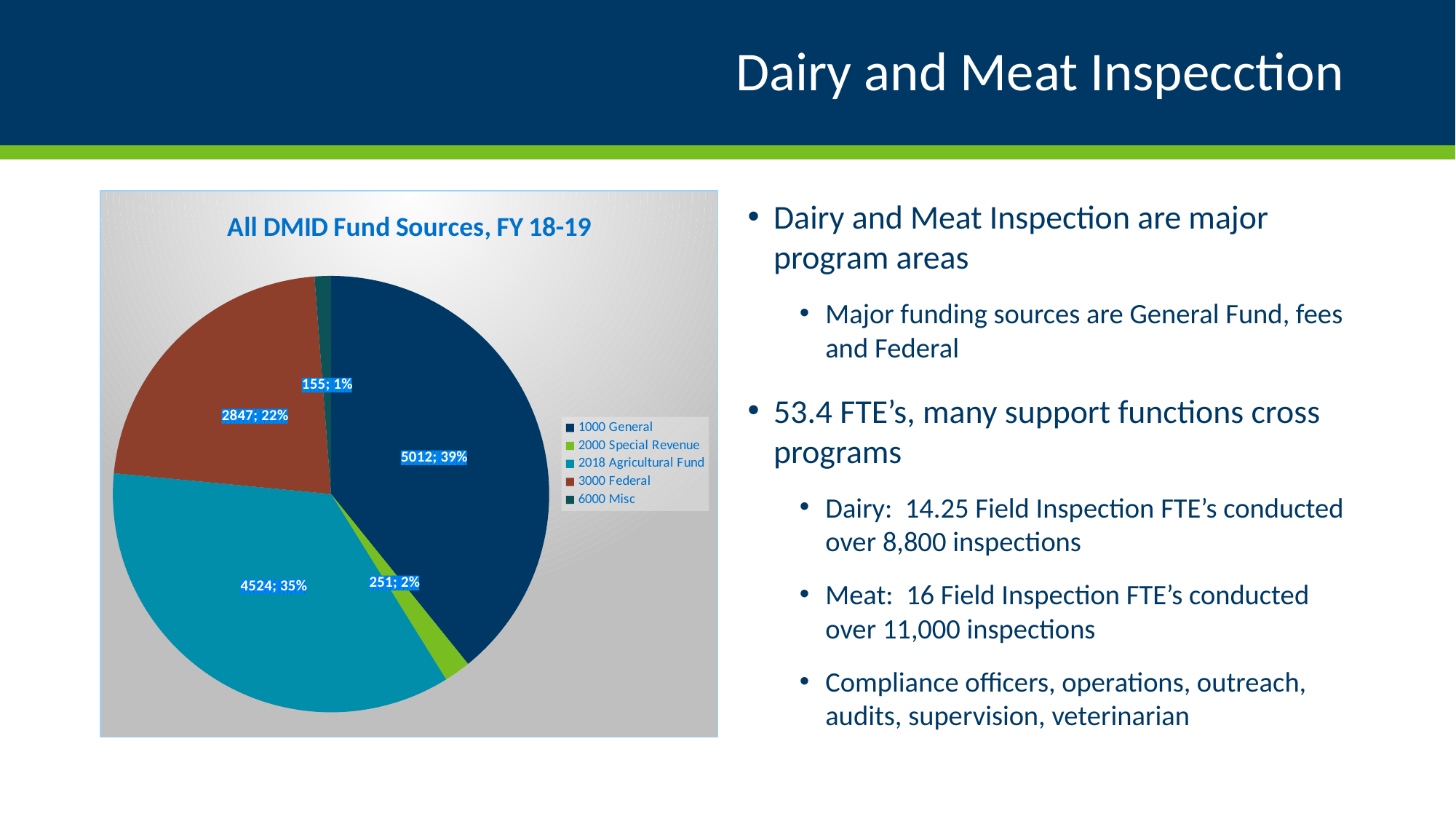
How many slices does the pie chart have? 5 What is the value for 3000 Federal? 2847 What is the value for 2018 Agricultural Fund? 4524 Which is larger, the value for 2000 Special Revenue or the value for 6000 Misc? 2000 Special Revenue Which fund source has the largest share of the pie? 1000 General What is the value for 6000 Misc? 155 What share of the pie does 2018 Agricultural Fund represent? 35% What is the value for 1000 General? 5012 What kind of chart is shown on the slide? pie chart Which fund source has the smallest share of the pie? 6000 Misc What is the difference between the values for 1000 General and 3000 Federal? 2165 What is the title of the pie chart? All DMID Fund Sources, FY 18-19